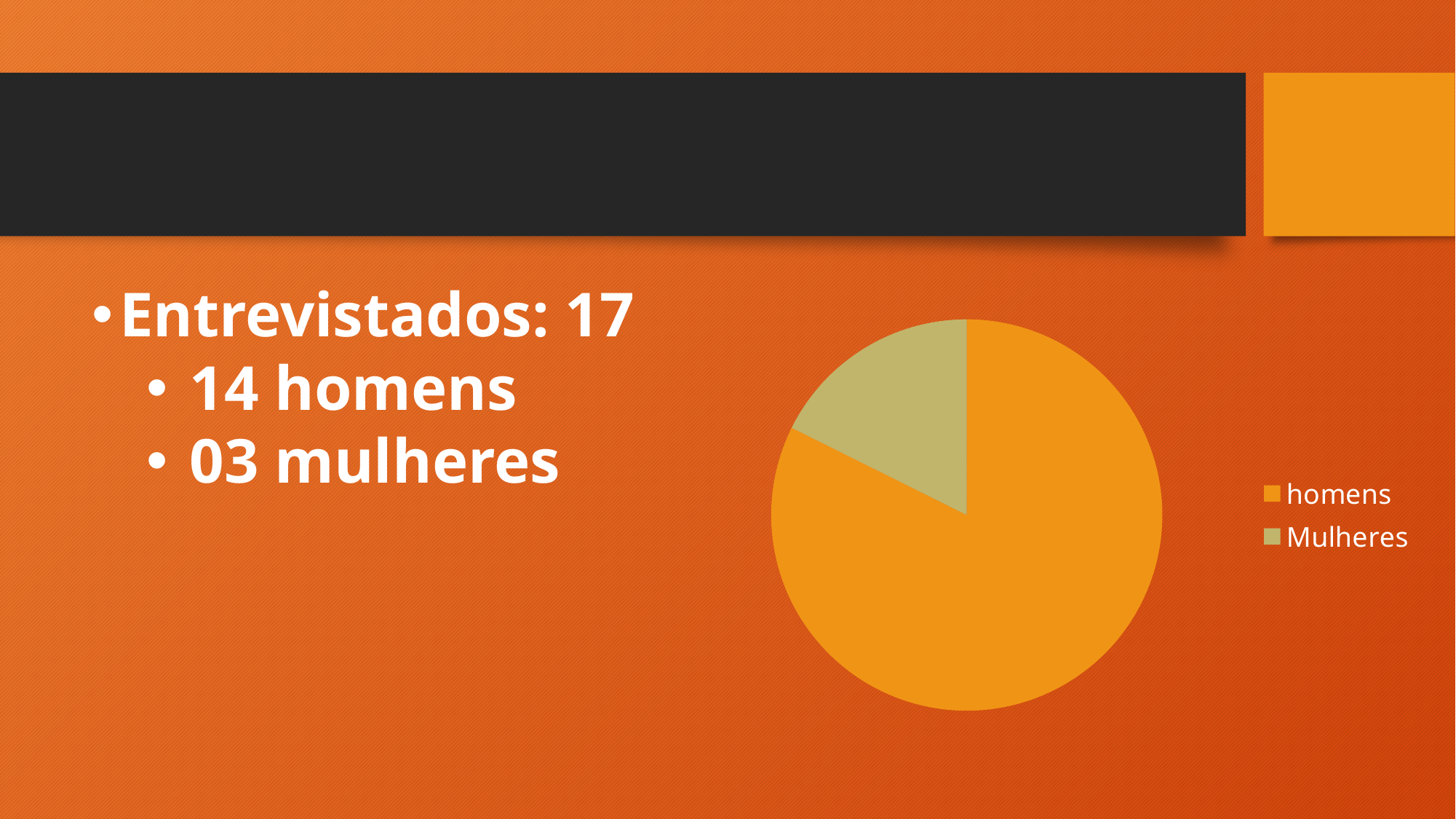
Which category has the largest slice in the pie chart? homens Which legend entry is shown in olive/khaki colour? Mulheres According to the slide, how many mulheres were interviewed? 03 Which slice is larger in the pie chart, homens or Mulheres? homens What colour is the homens slice in the pie chart? orange What kind of chart is shown on the slide? pie chart According to the slide, how many homens were interviewed? 14 How many slices does the pie chart have? 2 Which category has the smallest slice in the pie chart? Mulheres How many entries does the legend of the pie chart list? 2 What is the difference between the number of homens and mulheres interviewed? 11 What is the total number of entrevistados shown on the slide? 17